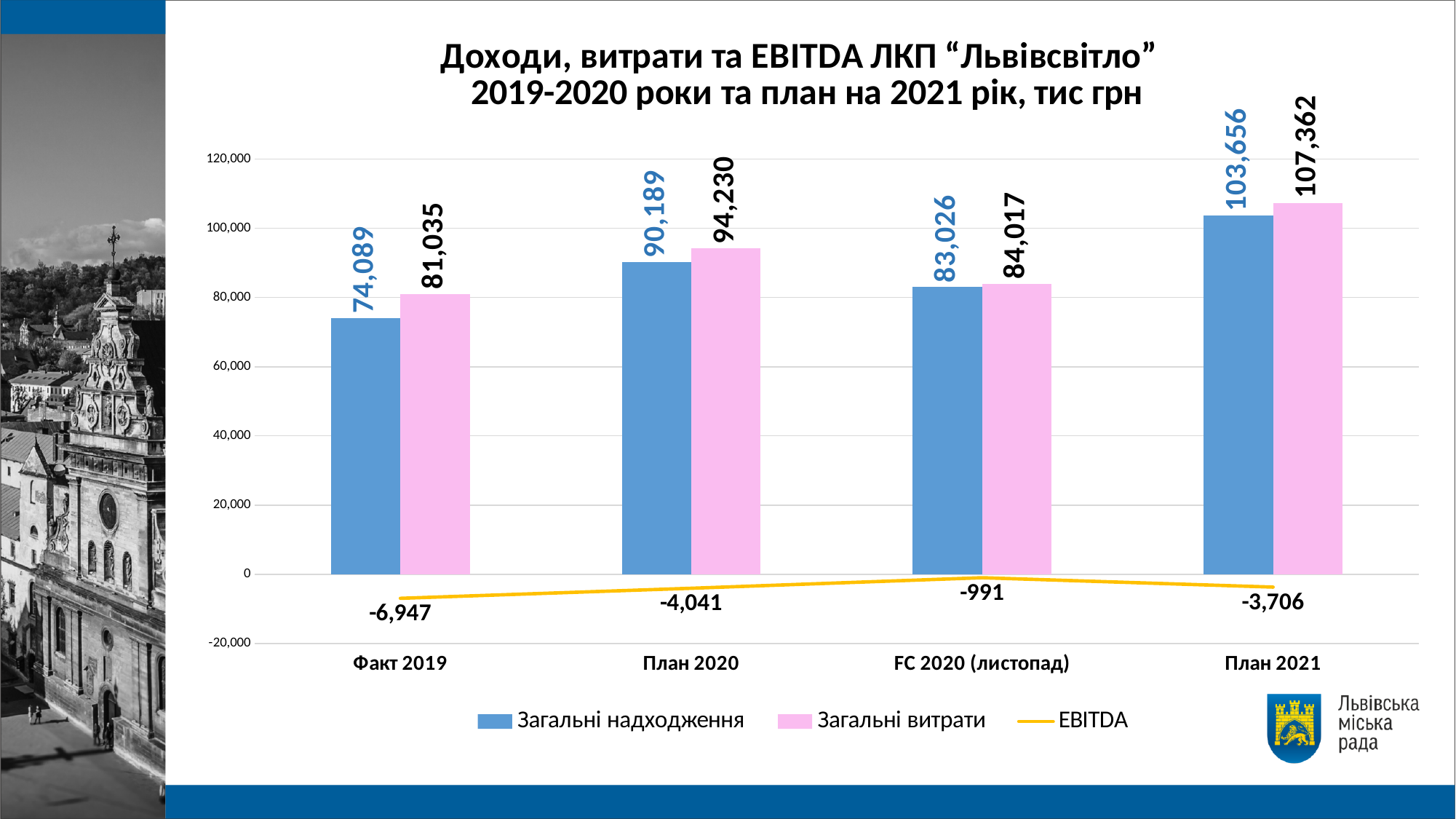
Which category has the lowest value of Загальні надходження? Факт 2019 How many series does the legend list? 3 How many categories are shown on the x axis? 4 Which series is plotted as a line rather than bars? EBITDA What is the difference between Загальні витрати and Загальні надходження for План 2020? 4,041 What is the value of Загальні надходження for Факт 2019? 74,089 What is the value of Загальні витрати for План 2021? 107,362 Which category has the highest value of Загальні витрати? План 2021 What is the EBITDA value for FC 2020 (листопад)? -991 Is the value of Загальні надходження for План 2021 greater or less than 100,000? greater Does the Загальні надходження series rise or fall from FC 2020 (листопад) to План 2021? rise Which is larger for Факт 2019: Загальні надходження or Загальні витрати? Загальні витрати